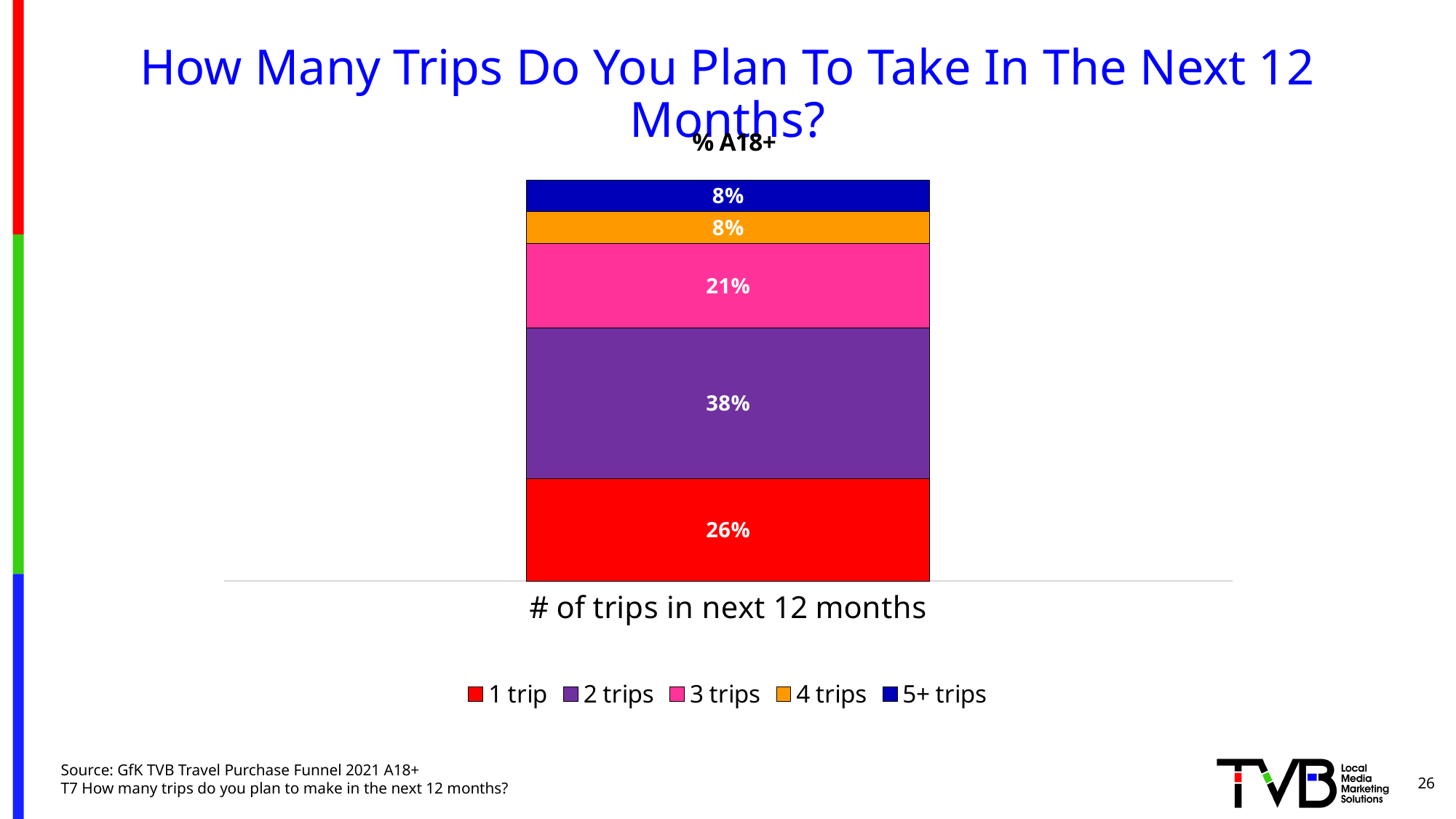
What percentage of adults 18+ plan to take 5+ trips in the next 12 months? 8% What is the difference in percentage points between the 3 trips and 4 trips segments? 13 What colour represents the 4 trips segment in the chart? Orange Which number of trips has the largest share of respondents? 2 trips What percentage of adults 18+ plan to take 2 trips in the next 12 months? 38% What type of chart is shown on the slide? Stacked bar chart What percentage of adults 18+ plan to take 1 trip in the next 12 months? 26% What percentage of adults 18+ plan to take 3 trips in the next 12 months? 21% What is the total of all segments in the stacked bar? 101% Which segment is larger: 1 trip or 3 trips? 1 trip What is the difference in percentage points between the 2 trips and 1 trip segments? 12 How many series does the legend list? 5